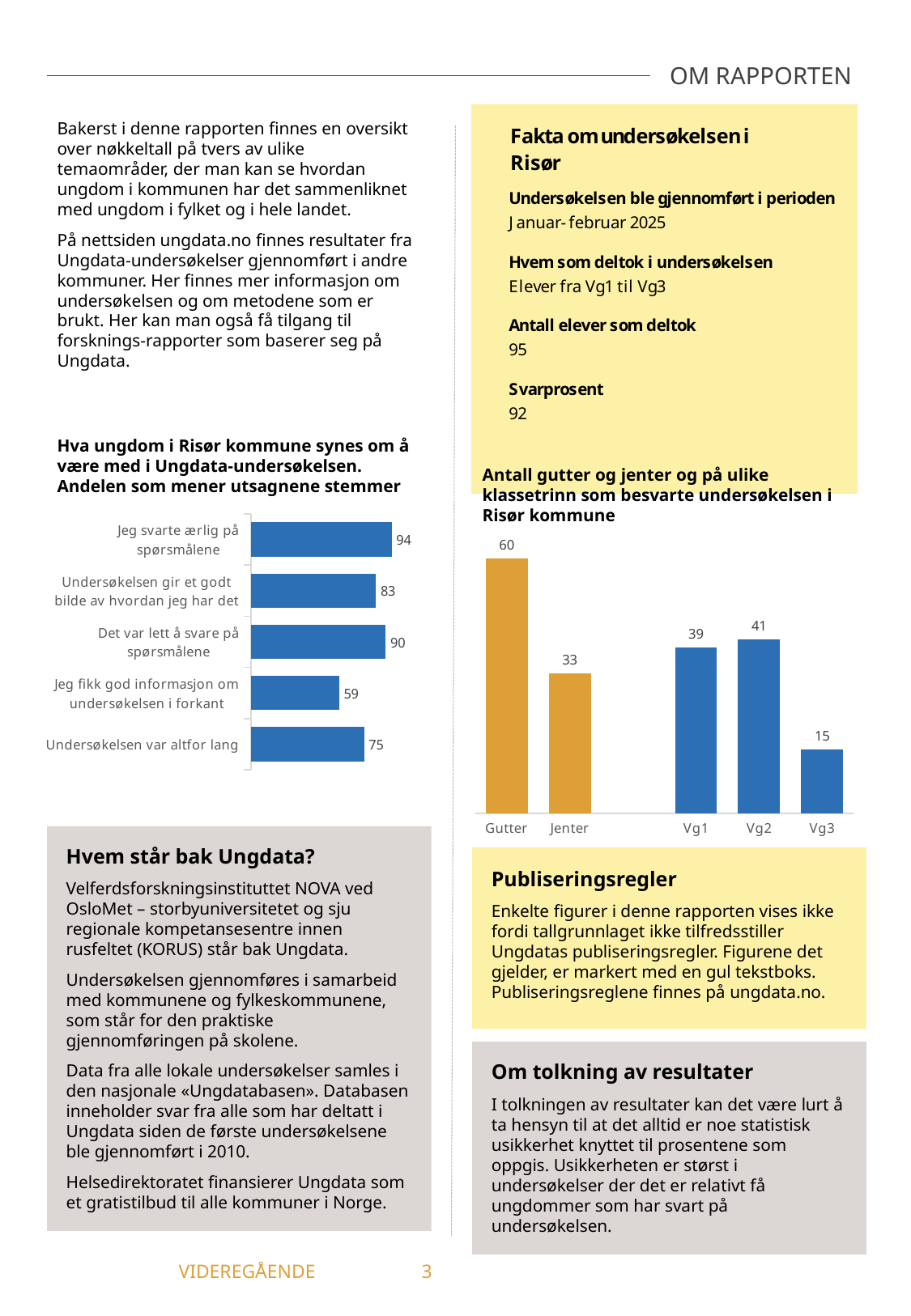
What kind of chart is 'Hva ungdom i Risør kommune synes om å være med i Ungdata-undersøkelsen'? Bar chart In the chart 'Antall gutter og jenter og på ulike klassetrinn som besvarte undersøkelsen i Risør kommune', which is larger, Vg1 or Vg3? Vg1 In the chart 'Antall gutter og jenter og på ulike klassetrinn som besvarte undersøkelsen i Risør kommune', what is the difference between Gutter and Jenter? 27 In the chart 'Hva ungdom i Risør kommune synes om å være med i Ungdata-undersøkelsen', what is the value for 'Jeg fikk god informasjon om undersøkelsen i forkant'? 59 In the chart 'Hva ungdom i Risør kommune synes om å være med i Ungdata-undersøkelsen', what is the value for 'Jeg svarte ærlig på spørsmålene'? 94 In the chart 'Antall gutter og jenter og på ulike klassetrinn som besvarte undersøkelsen i Risør kommune', what is the value for Gutter? 60 In the chart 'Antall gutter og jenter og på ulike klassetrinn som besvarte undersøkelsen i Risør kommune', which category has the highest value? Gutter In the chart 'Antall gutter og jenter og på ulike klassetrinn som besvarte undersøkelsen i Risør kommune', what colour are the bars for Gutter and Jenter? Orange In the chart 'Antall gutter og jenter og på ulike klassetrinn som besvarte undersøkelsen i Risør kommune', what is the value for Vg3? 15 In the chart 'Hva ungdom i Risør kommune synes om å være med i Ungdata-undersøkelsen', what is the difference between 'Det var lett å svare på spørsmålene' and 'Undersøkelsen var altfor lang'? 15 In the chart 'Hva ungdom i Risør kommune synes om å være med i Ungdata-undersøkelsen', how many statements are shown? 5 In the chart 'Hva ungdom i Risør kommune synes om å være med i Ungdata-undersøkelsen', which statement has the lowest value? Jeg fikk god informasjon om undersøkelsen i forkant